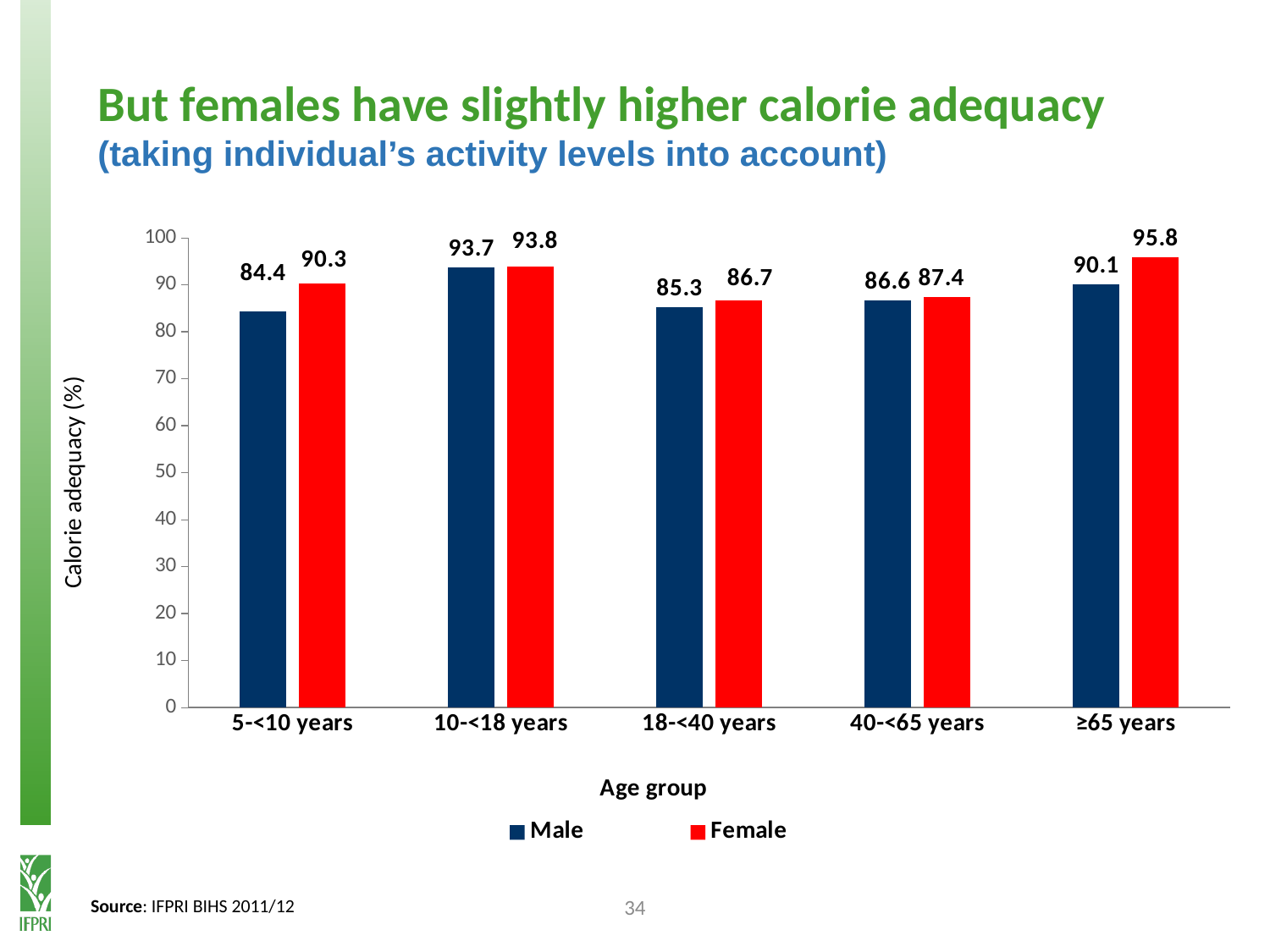
Which is larger: male calorie adequacy for 10-<18 years or male calorie adequacy for ≥65 years? 10-<18 years What kind of chart is shown on the slide? Bar chart What is the label of the y axis? Calorie adequacy (%) Which colour represents the Female series in the legend? Red How many series does the legend list? 2 Which age group has the lowest calorie adequacy for males? 5-<10 years Which age group has the highest calorie adequacy for females? ≥65 years What is the calorie adequacy for females in the ≥65 years age group? 95.8 How many age groups are shown on the x axis? 5 What is the calorie adequacy for males in the 5-<10 years age group? 84.4 What is the calorie adequacy for females in the 18-<40 years age group? 86.7 What is the difference between female and male calorie adequacy in the 5-<10 years age group? 5.9